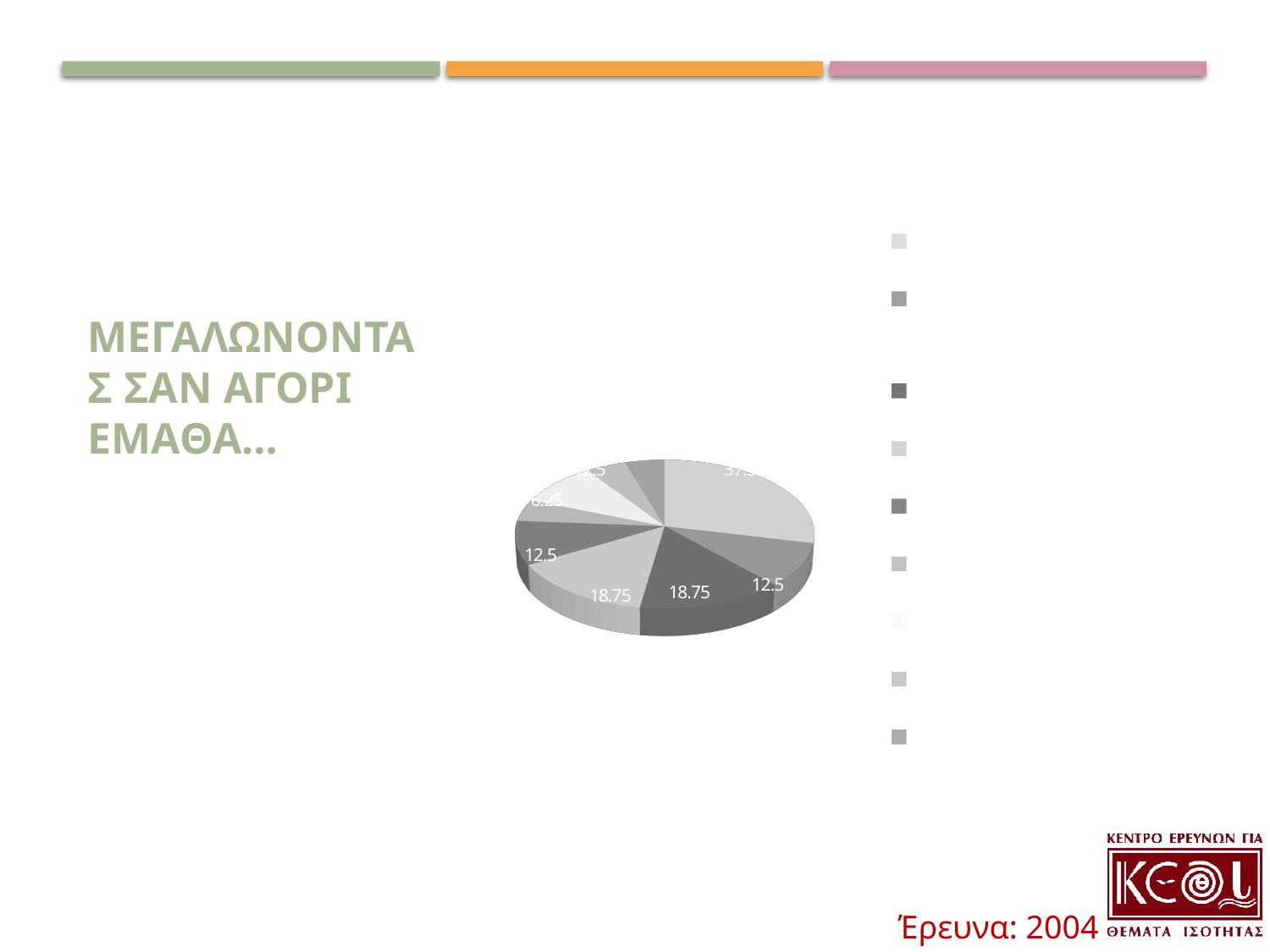
What year is given for the survey (Έρευνα) at the bottom of the slide? 2004 What is the heading text to the left of the pie chart? ΜΕΓΑΛΩΝΟΝΤΑΣ ΣΑΝ ΑΓΟΡΙ ΕΜΑΘΑ... Which is larger, the slice labelled 37.5 or the slice labelled 6.25? 37.5 How many slices of the pie chart are labelled 18.75? 2 What is the difference between a slice labelled 18.75 and a slice labelled 12.5? 6.25 What kind of chart is shown on the slide? pie chart What is the smallest value labelled on the pie chart? 6.25 Is the value of the largest slice greater or less than 30? greater What is the value of the largest slice of the pie chart? 37.5 How many entries does the legend to the right of the pie chart list? 9